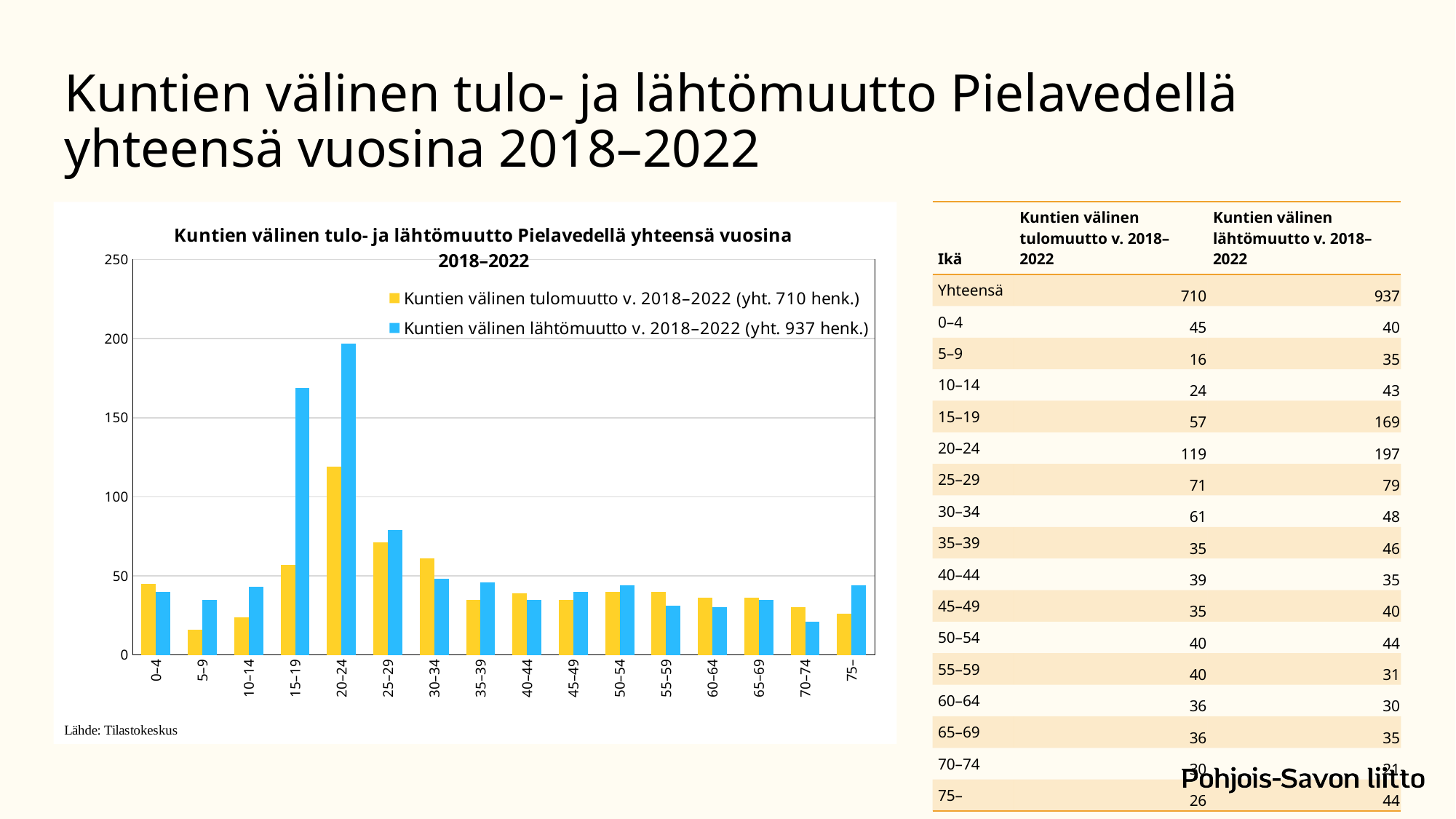
How many age groups are shown on the x axis of the chart? 16 Which age group has the highest value for Kuntien välinen lähtömuutto v. 2018–2022? 20–24 Is the value for Kuntien välinen lähtömuutto in the 15–19 age group greater or less than 150? greater Is the value for Kuntien välinen tulomuutto in the 20–24 age group greater or less than 100? greater How many series does the chart legend list? 2 Which age group has the lowest value for Kuntien välinen tulomuutto v. 2018–2022? 5–9 Which age group has the lowest value for Kuntien välinen lähtömuutto v. 2018–2022? 70–74 According to the legend, what is the total number of persons (yht.) for Kuntien välinen lähtömuutto v. 2018–2022? 937 henk. In the 15–19 age group, which is larger: Kuntien välinen tulomuutto or Kuntien välinen lähtömuutto? Kuntien välinen lähtömuutto What type of chart is shown on the slide? bar chart In the 30–34 age group, which is larger: Kuntien välinen tulomuutto or Kuntien välinen lähtömuutto? Kuntien välinen tulomuutto What is the value of Kuntien välinen tulomuutto v. 2018–2022 for the 20–24 age group? 119